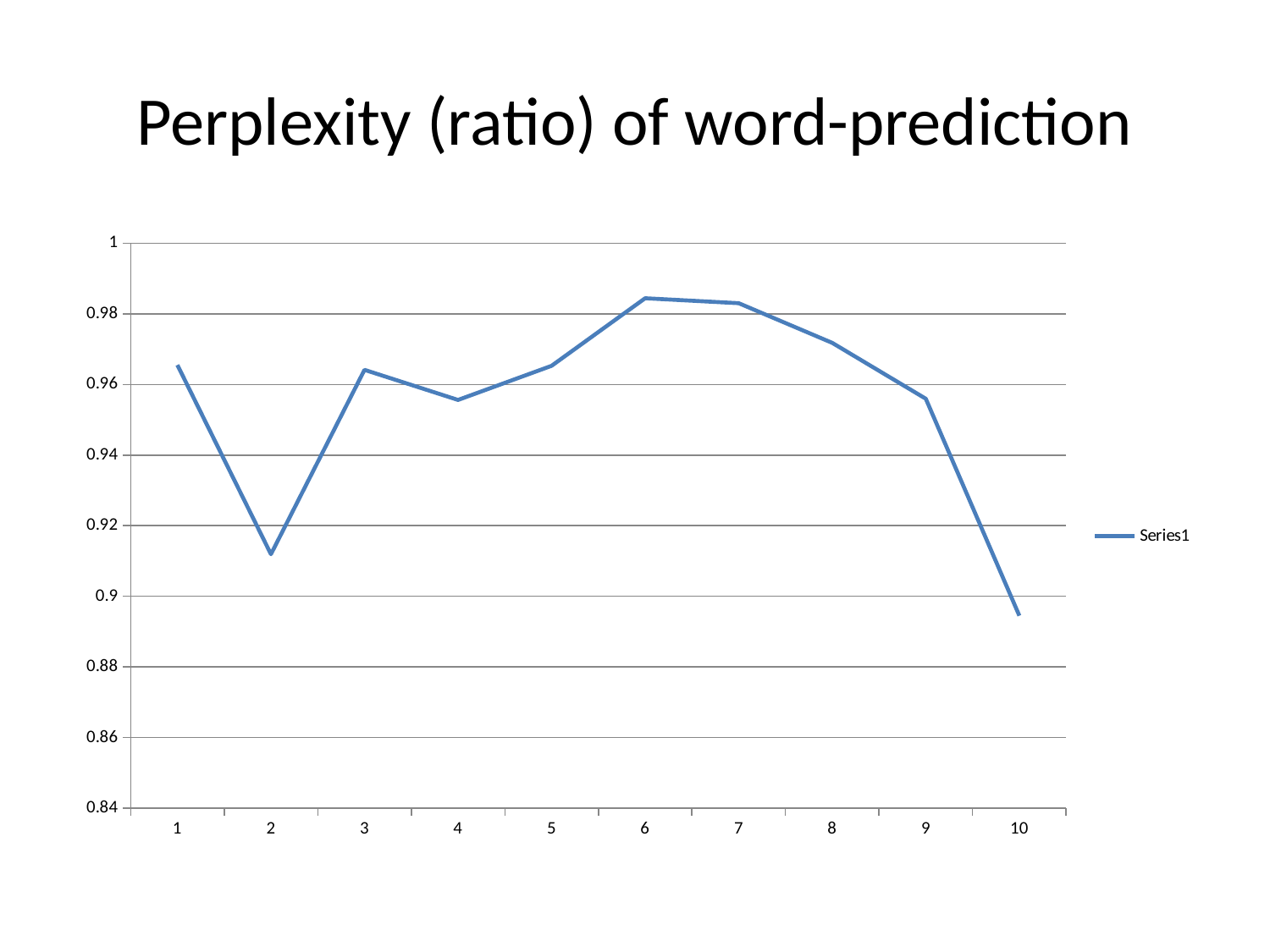
Is the value at point 10 greater or less than 0.9? less What is the title of the chart? Perplexity (ratio) of word-prediction Is the value at point 6 greater or less than 0.98? greater What is the name of the series shown in the legend? Series1 At which x-axis point is the value lowest? 10 How many points are plotted along the x axis? 10 Which has the larger value, point 2 or point 10? 2 Do the values rise or fall from point 6 to point 10? fall What kind of chart is shown on the slide? line chart How many series does the legend list? 1 Is the value at point 8 greater or less than 0.96? greater